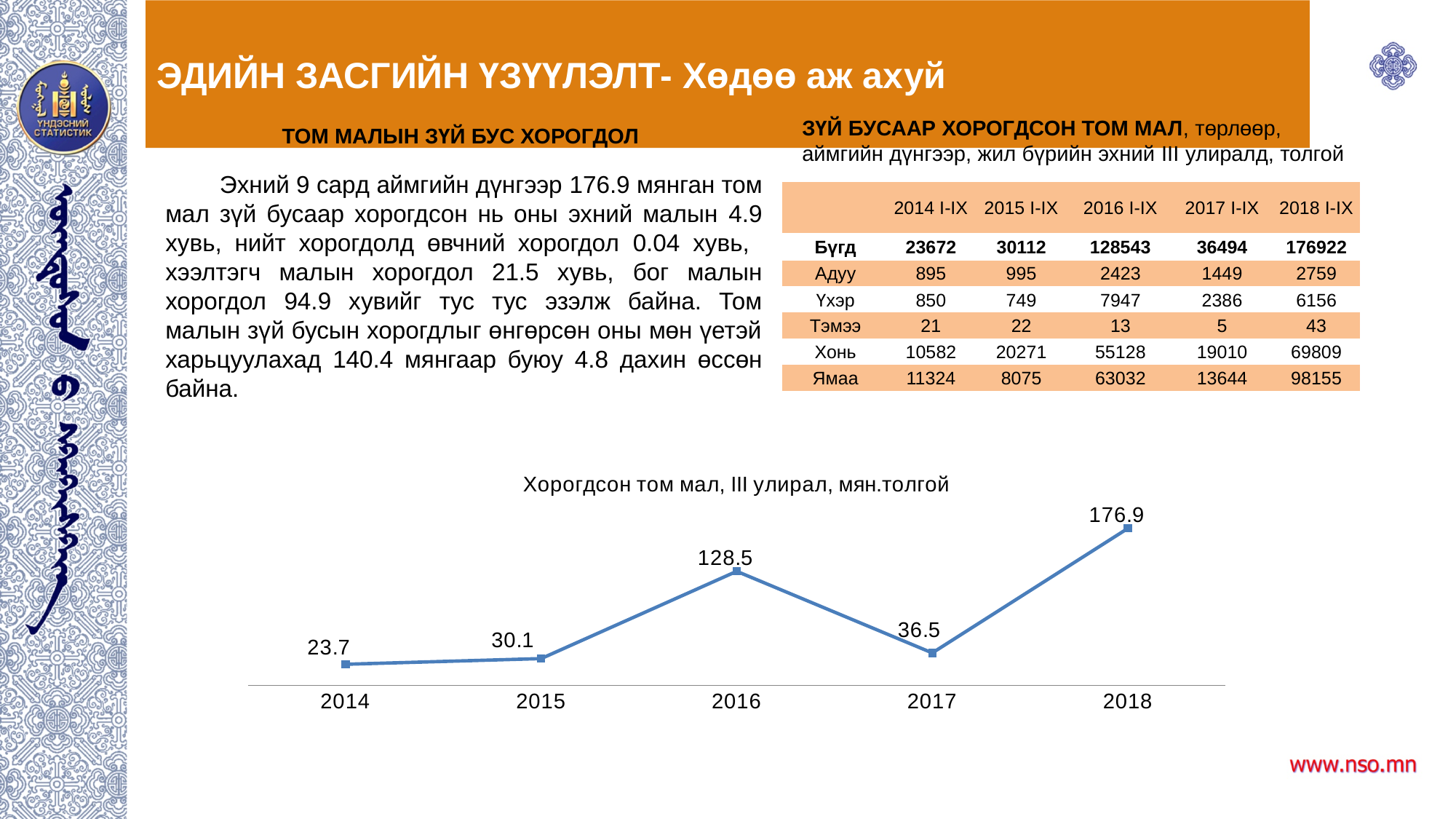
How many data points are plotted in the chart? 5 What is the value for 2018 in the chart? 176.9 What is the title of the chart? Хорогдсон том мал, III улирал, мян.толгой What is the difference between the values for 2016 and 2015? 98.4 What type of chart is shown on the slide? line chart Which year has the highest value in the chart? 2018 Which year has the lowest value in the chart? 2014 What is the value for 2016 in the chart? 128.5 Does the value rise or fall from 2016 to 2017? fall Which is larger, the value for 2016 or the value for 2017? 2016 What is the difference between the values for 2018 and 2017? 140.4 What is the value for 2014 in the chart? 23.7